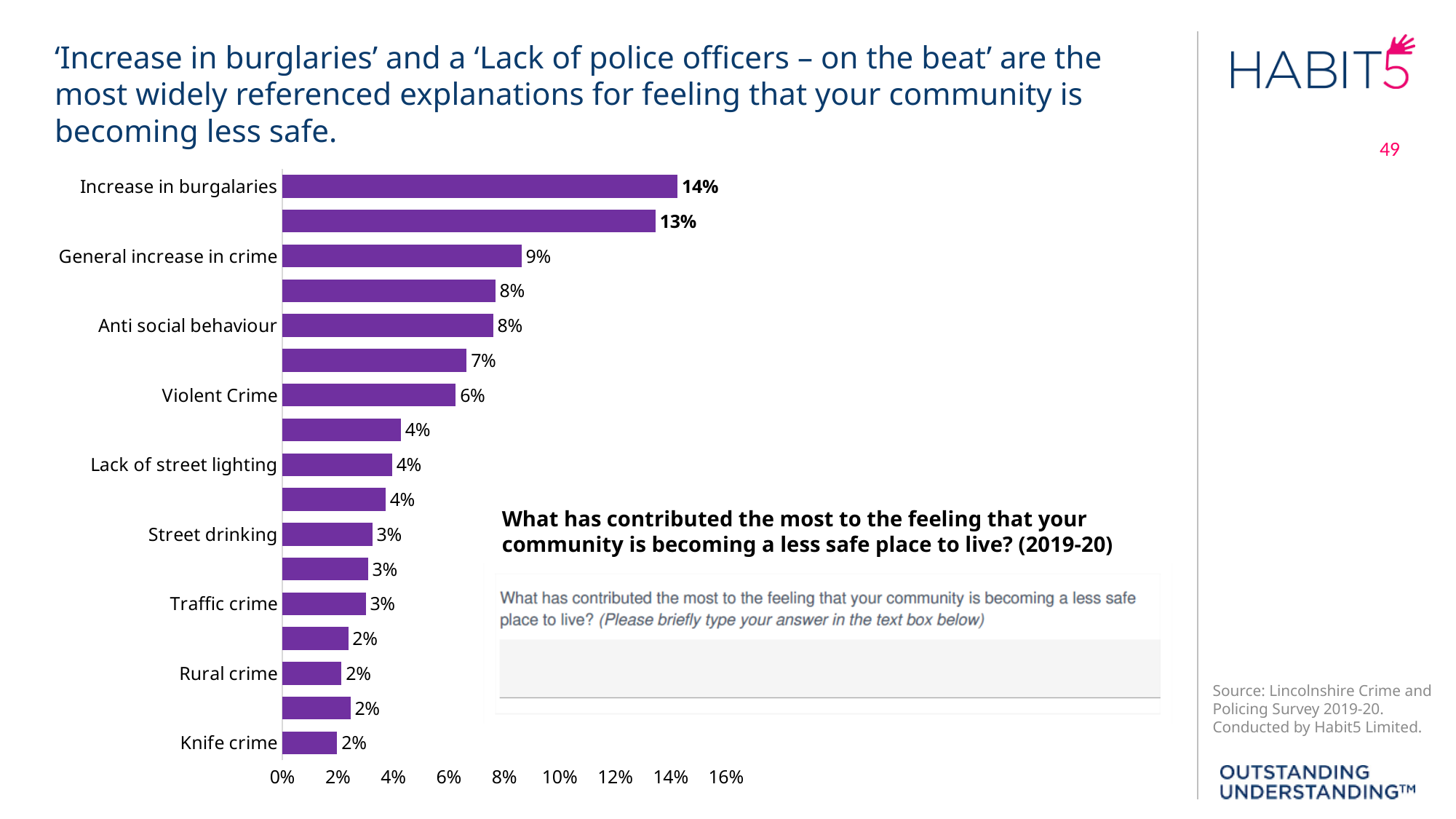
What percentage is shown for 'Increase in burgalaries'? 14% Do the bar values increase or decrease going from the top of the chart to the bottom? Decrease What type of chart is shown on the slide? Bar chart What is the value for 'Violent Crime'? 6% Which has a larger value, 'Violent Crime' or 'Street drinking'? Violent Crime What percentage is shown for 'Lack of street lighting'? 4% What percentage is shown for 'Anti social behaviour'? 8% Which labelled category has the highest value in the chart? Increase in burgalaries How many bars are plotted in the chart? 17 What is the value for 'General increase in crime'? 9% What is the difference between the values for 'Increase in burgalaries' and 'General increase in crime'? 5 percentage points What is the value for 'Knife crime'? 2%